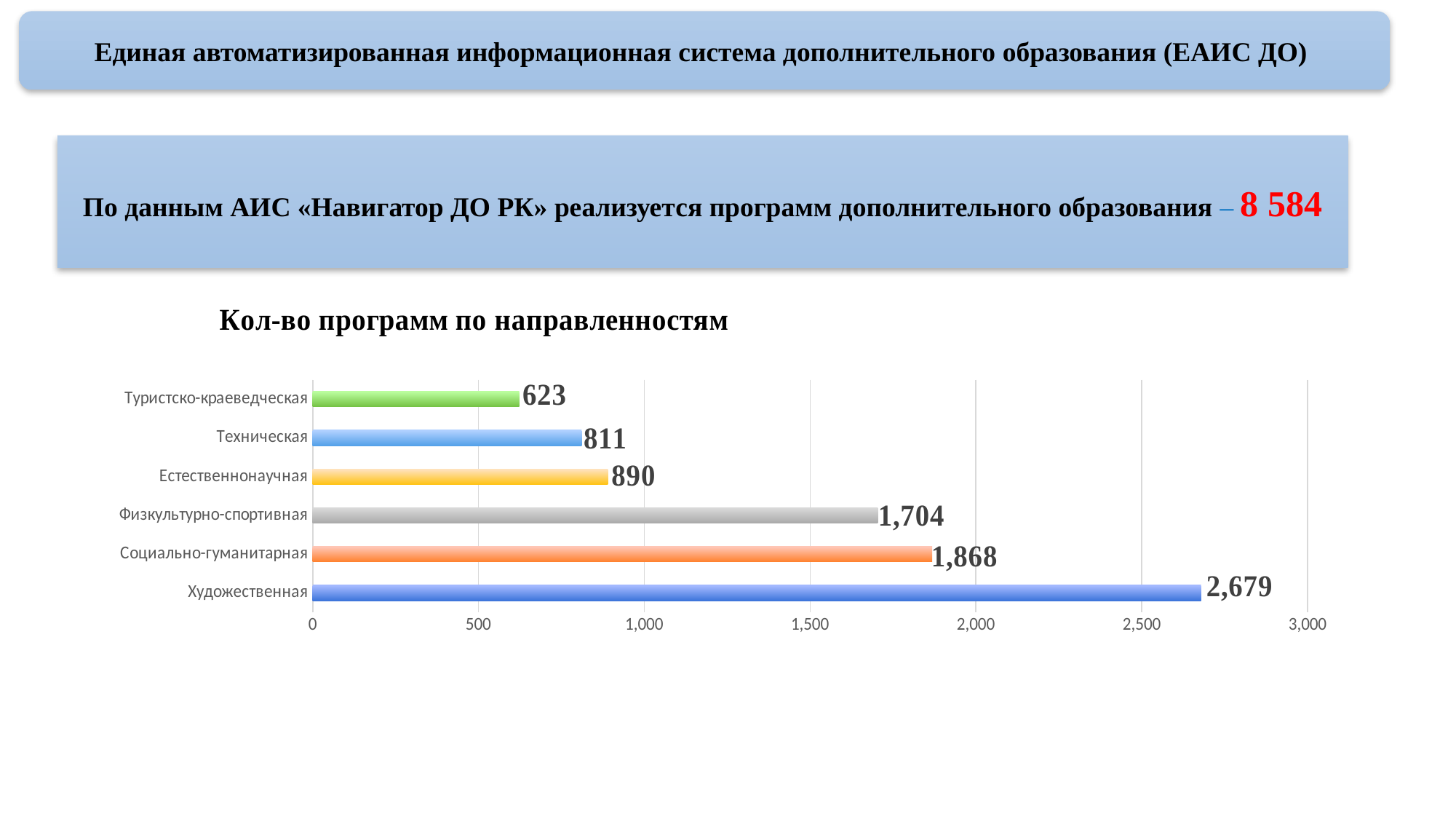
What is the value for Техническая? 811 Which category has the highest value? Художественная What is the difference between the values for Социально-гуманитарная and Физкультурно-спортивная? 164 What kind of chart is shown on the slide? bar chart What is the value for Физкультурно-спортивная? 1,704 What is the difference between the values for Художественная and Туристско-краеведческая? 2,056 Is the value for Социально-гуманитарная greater or less than 1,500? greater What is the value for Художественная? 2,679 What is the title of the chart? Кол-во программ по направленностям Which is larger, the value for Естественнонаучная or the value for Техническая? Естественнонаучная How many categories are shown in the chart? 6 Which category has the lowest value? Туристско-краеведческая